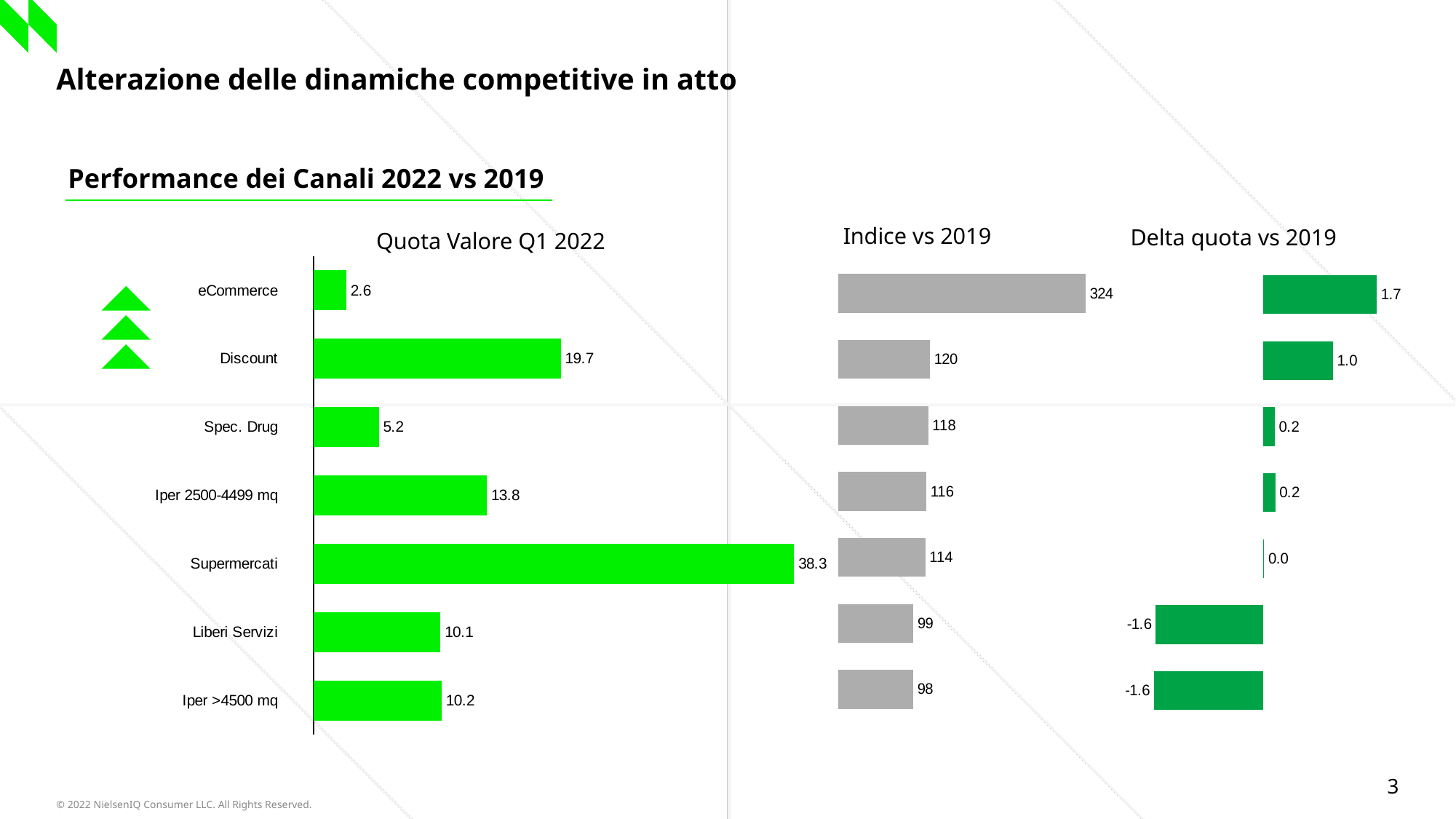
In the 'Quota Valore Q1 2022' chart, what is the value for Discount? 19.7 In the 'Quota Valore Q1 2022' chart, which is larger, the value for Iper 2500-4499 mq or the value for Liberi Servizi? Iper 2500-4499 mq In the 'Quota Valore Q1 2022' chart, which category has the highest value? Supermercati What kind of chart is the 'Indice vs 2019' chart? Bar chart In the 'Delta quota vs 2019' chart, what is the value for Discount? 1.0 In the 'Quota Valore Q1 2022' chart, what is the difference between the values for Supermercati and Discount? 18.6 In the 'Quota Valore Q1 2022' chart, which category has the lowest value? eCommerce How many categories are shown in the 'Quota Valore Q1 2022' chart? 7 In the 'Indice vs 2019' chart, what is the difference between the values for Discount and Spec. Drug? 2 In the 'Indice vs 2019' chart, which category has the lowest value? Iper >4500 mq In the 'Indice vs 2019' chart, what is the value for eCommerce? 324 In the 'Delta quota vs 2019' chart, what is the value for Supermercati? 0.0